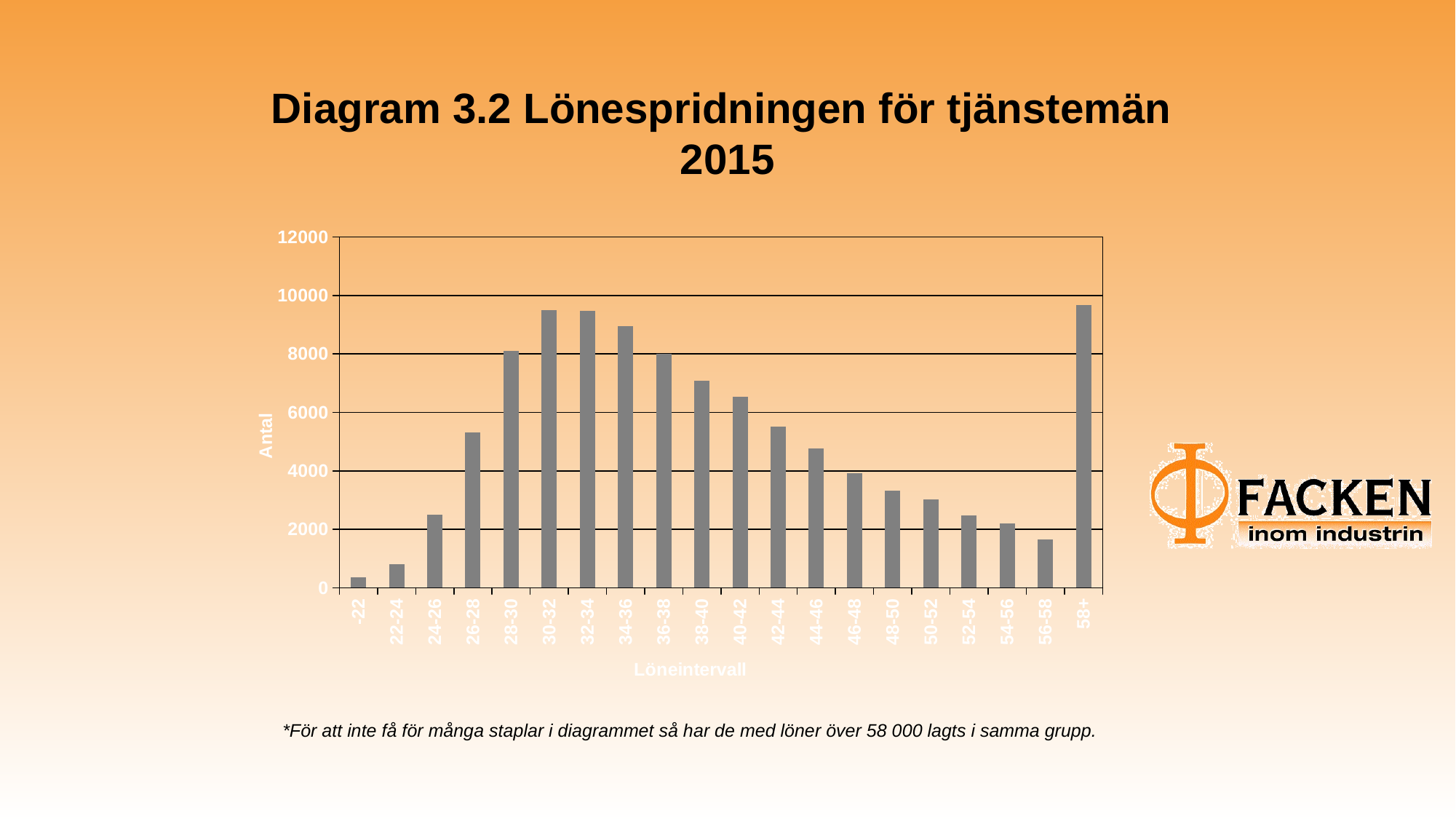
Which is larger, the value for 42-44 or the value for 46-48? 42-44 What is the title of the vertical axis? Antal Is the value for 30-32 greater or less than 8000? greater Is the value for 22-24 greater or less than 2000? less Is the value for 38-40 greater or less than 6000? greater How many salary interval categories are shown on the x axis? 20 Do the values rise or fall from 30-32 through 56-58? fall Which is larger, the value for 34-36 or the value for 40-42? 34-36 What kind of chart is shown on the slide? bar chart Which salary interval has the lowest value? -22